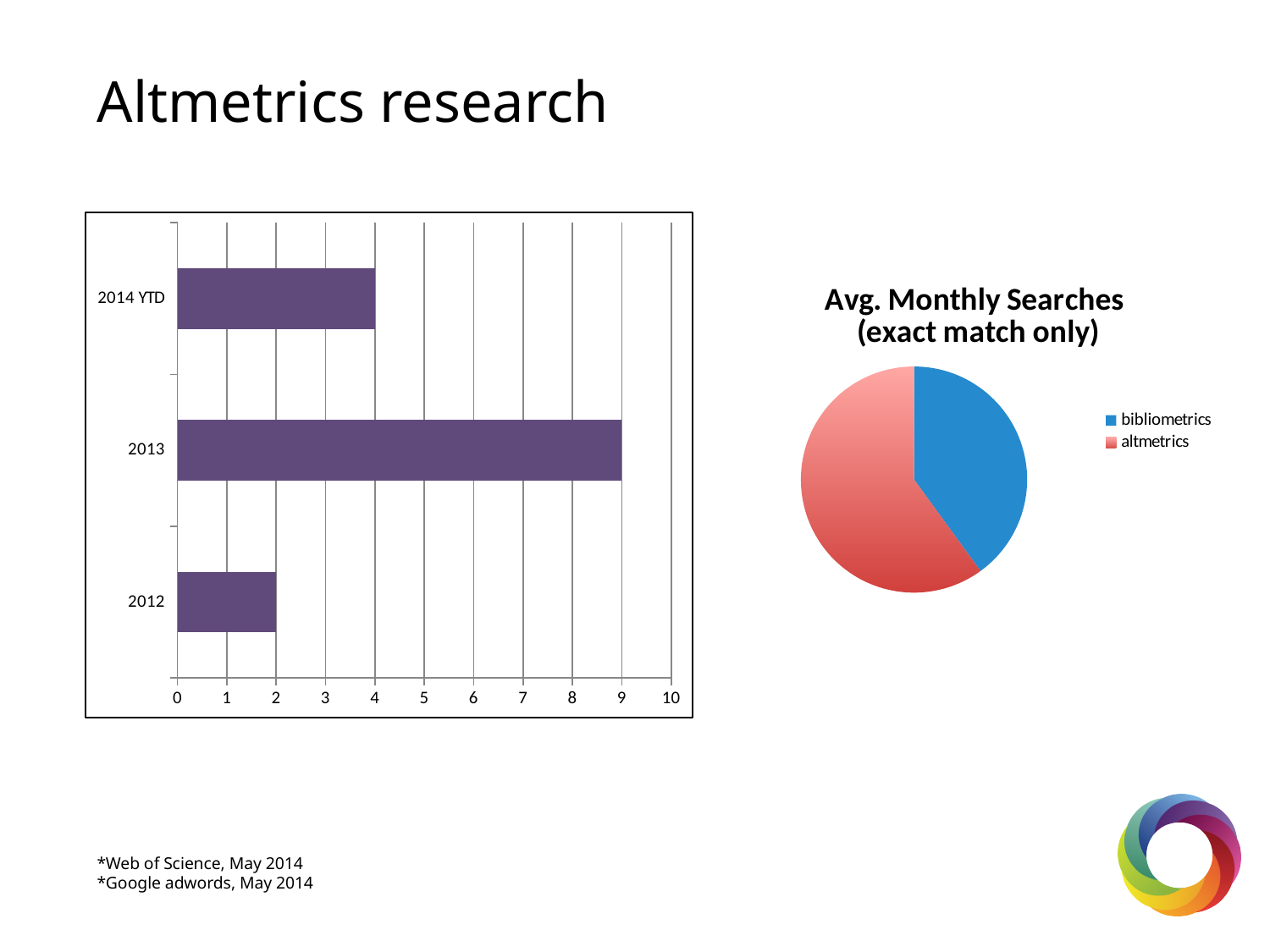
On the bar chart on the left, what is the value for 2013? 9 In the 'Avg. Monthly Searches (exact match only)' chart, what colour is the bibliometrics slice? blue On the bar chart on the left, which category has the lowest value? 2012 On the bar chart on the left, which category has the highest value? 2013 On the bar chart on the left, what is the value for 2012? 2 How many entries does the legend of the 'Avg. Monthly Searches (exact match only)' chart list? 2 On the bar chart on the left, what is the difference between the values for 2013 and 2012? 7 On the bar chart on the left, which is larger, the value for 2014 YTD or the value for 2012? 2014 YTD On the bar chart on the left, how many categories are shown? 3 What kind of chart is the chart on the left of the slide? bar chart On the bar chart on the left, what is the value for 2014 YTD? 4 In the 'Avg. Monthly Searches (exact match only)' chart, which slice is larger, bibliometrics or altmetrics? altmetrics